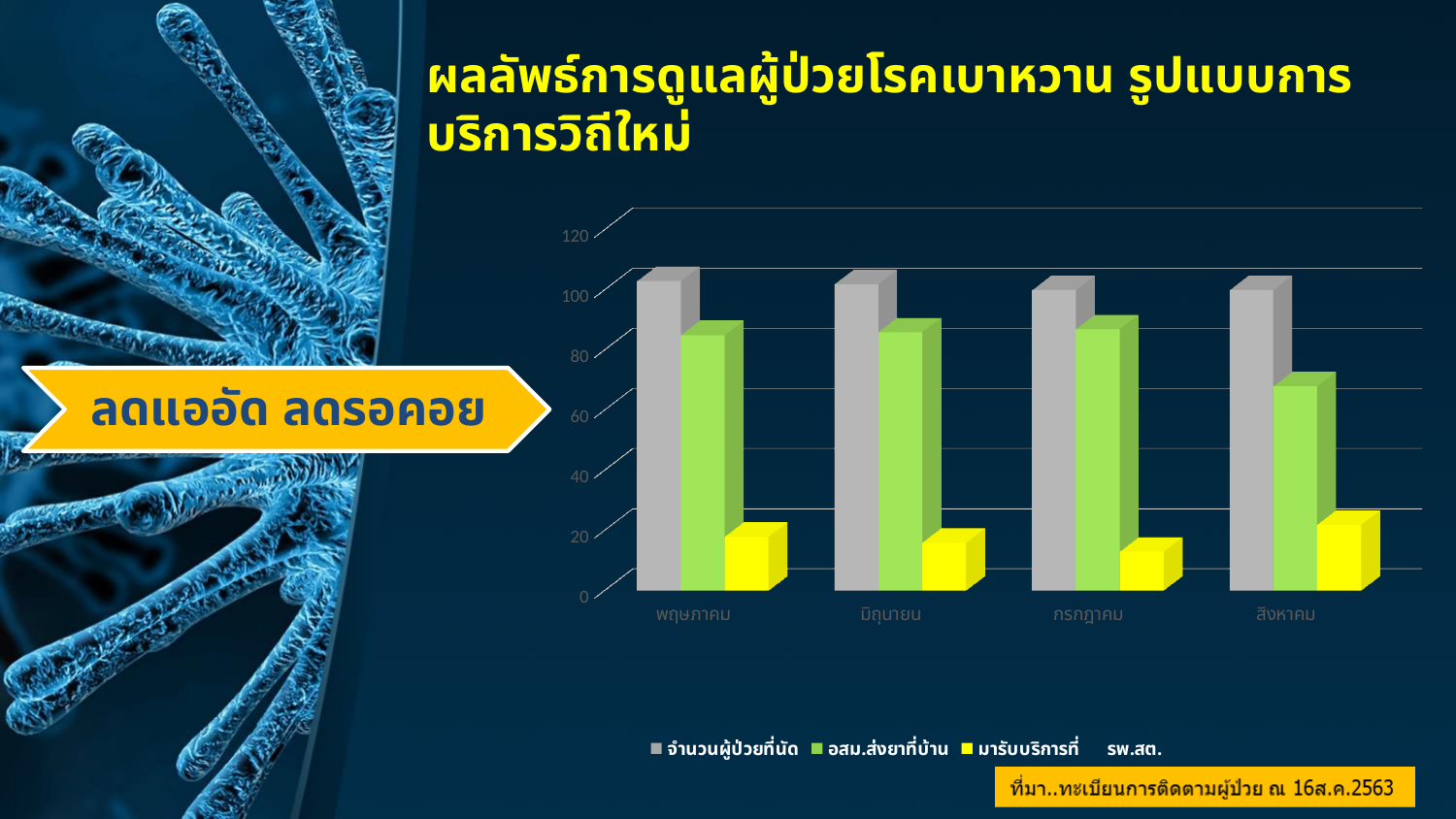
Which series is shown in green in the chart? อสม.ส่งยาที่บ้าน Is the value of อสม.ส่งยาที่บ้าน for มิถุนายน greater or less than 60? greater Is the value of จำนวนผู้ป่วยที่นัด for พฤษภาคม greater or less than 80? greater In which month is the value of อสม.ส่งยาที่บ้าน lowest? สิงหาคม How many series does the chart legend list? 3 For อสม.ส่งยาที่บ้าน, which is larger: มิถุนายน or สิงหาคม? มิถุนายน How many months are shown on the x axis of the chart? 4 Is the value of อสม.ส่งยาที่บ้าน for สิงหาคม greater or less than 80? less Which series is shown in yellow in the chart? มารับบริการที่ รพ.สต. What kind of chart is shown on the slide? bar chart In สิงหาคม, which is larger: จำนวนผู้ป่วยที่นัด or อสม.ส่งยาที่บ้าน? จำนวนผู้ป่วยที่นัด